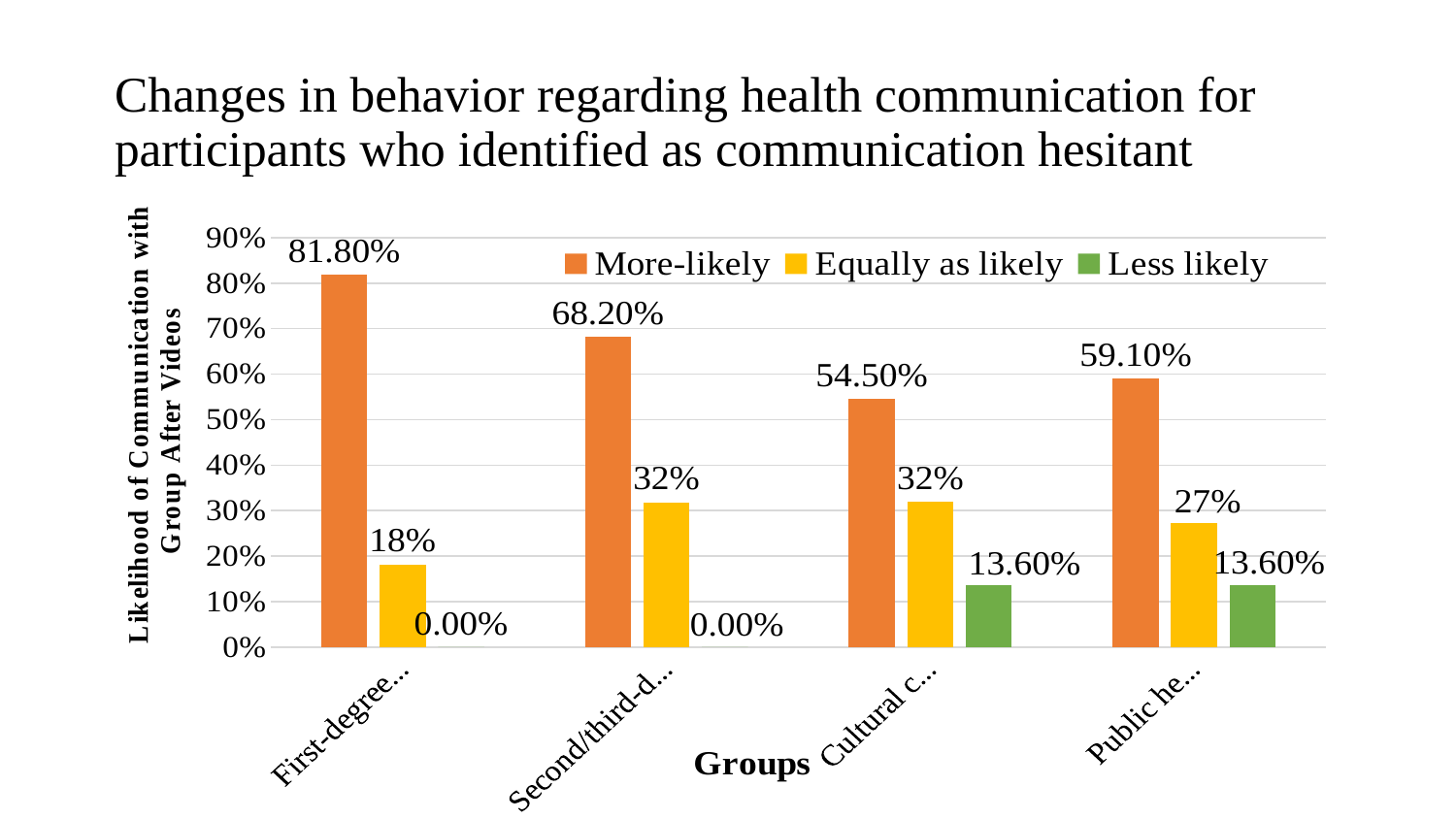
Which group has the highest More-likely value? First-degree... What is the More-likely value for the third group (Cultural c...)? 54.50% What is the difference between the More-likely values for the first group (First-degree...) and the second group (Second/third-d...)? 13.60% Which group has the lowest More-likely value? Cultural c... What type of chart is shown on the slide? bar chart Which is larger: the Equally as likely value for the first group (First-degree...) or for the fourth group (Public he...)? Public he... What is the More-likely value for the first group (First-degree...)? 81.80% What is the title of the y axis? Likelihood of Communication with Group After Videos How many series does the legend list? 3 What is the Less likely value for the fourth group (Public he...)? 13.60% What is the Equally as likely value for the second group (Second/third-d...)? 32% How many groups are shown along the x axis? 4